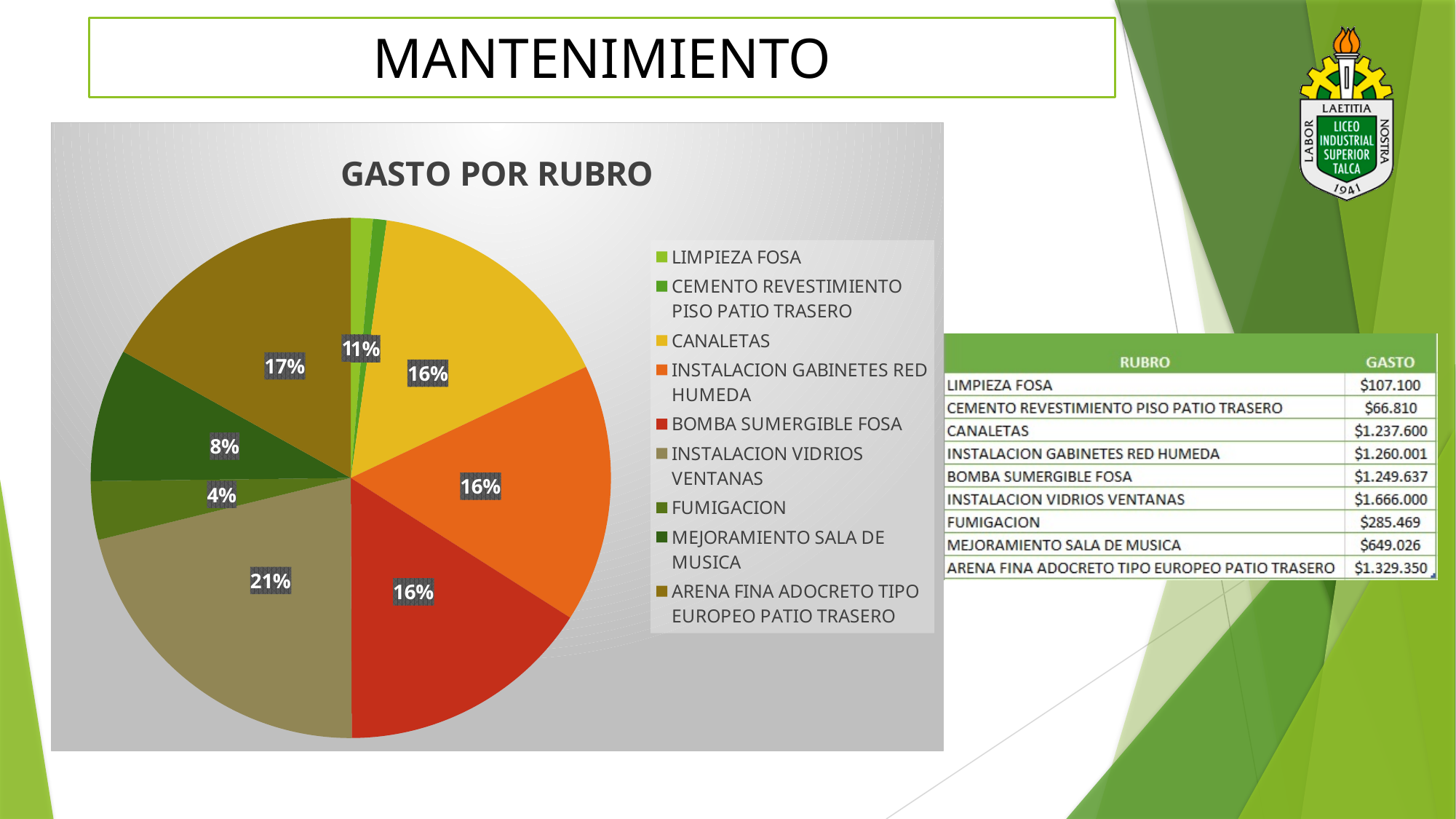
What share of the pie does ARENA FINA ADOCRETO TIPO EUROPEO PATIO TRASERO represent? 17% What share of the pie does INSTALACION VIDRIOS VENTANAS represent? 21% By how many percentage points does the share of INSTALACION VIDRIOS VENTANAS exceed that of ARENA FINA ADOCRETO TIPO EUROPEO PATIO TRASERO? 4 percentage points What is the title of the chart? GASTO POR RUBRO What percentage is shown for FUMIGACION? 4% Which is larger, the slice for INSTALACION VIDRIOS VENTANAS or the slice for ARENA FINA ADOCRETO TIPO EUROPEO PATIO TRASERO? INSTALACION VIDRIOS VENTANAS What colour is the CANALETAS slice in the pie chart? yellow How many categories does the pie chart's legend list? 9 What kind of chart is shown on the slide? pie chart Which category has the largest slice of the pie? INSTALACION VIDRIOS VENTANAS What percentage is shown for MEJORAMIENTO SALA DE MUSICA? 8% What percentage is shown for CANALETAS? 16%